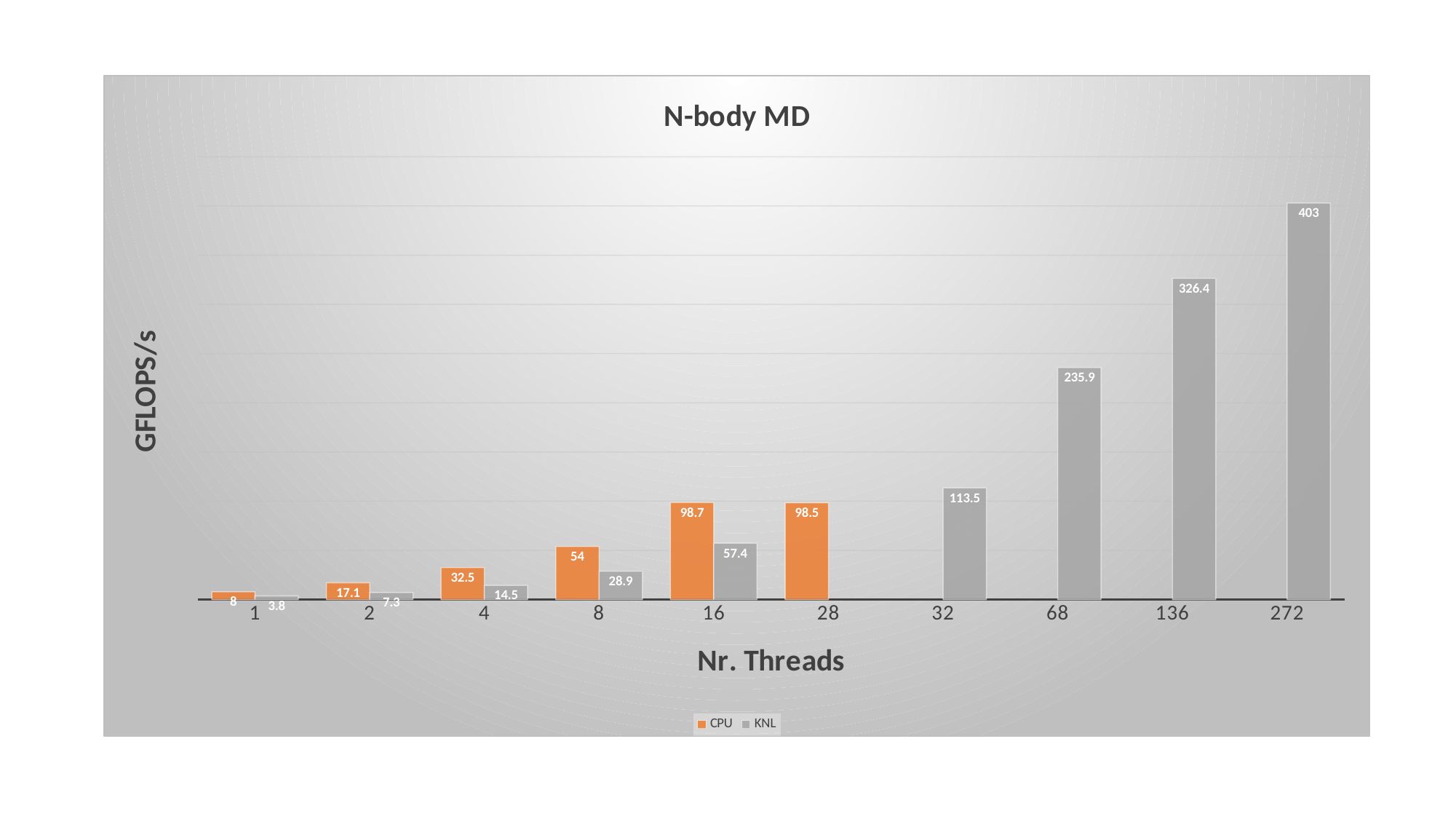
What kind of chart is shown? Bar chart What is the CPU value at 4 threads? 32.5 What is the title of the chart? N-body MD What is the difference between the KNL values at 136 and 68 threads? 90.5 Which is larger at 8 threads, the CPU value or the KNL value? CPU What is the KNL value at 272 threads? 403 What is the CPU value at 16 threads? 98.7 What is the difference between the CPU and KNL values at 16 threads? 41.3 What is the KNL value at 8 threads? 28.9 At which number of threads is the KNL value highest? 272 How many series does the legend list? 2 At which number of threads is the CPU value lowest? 1